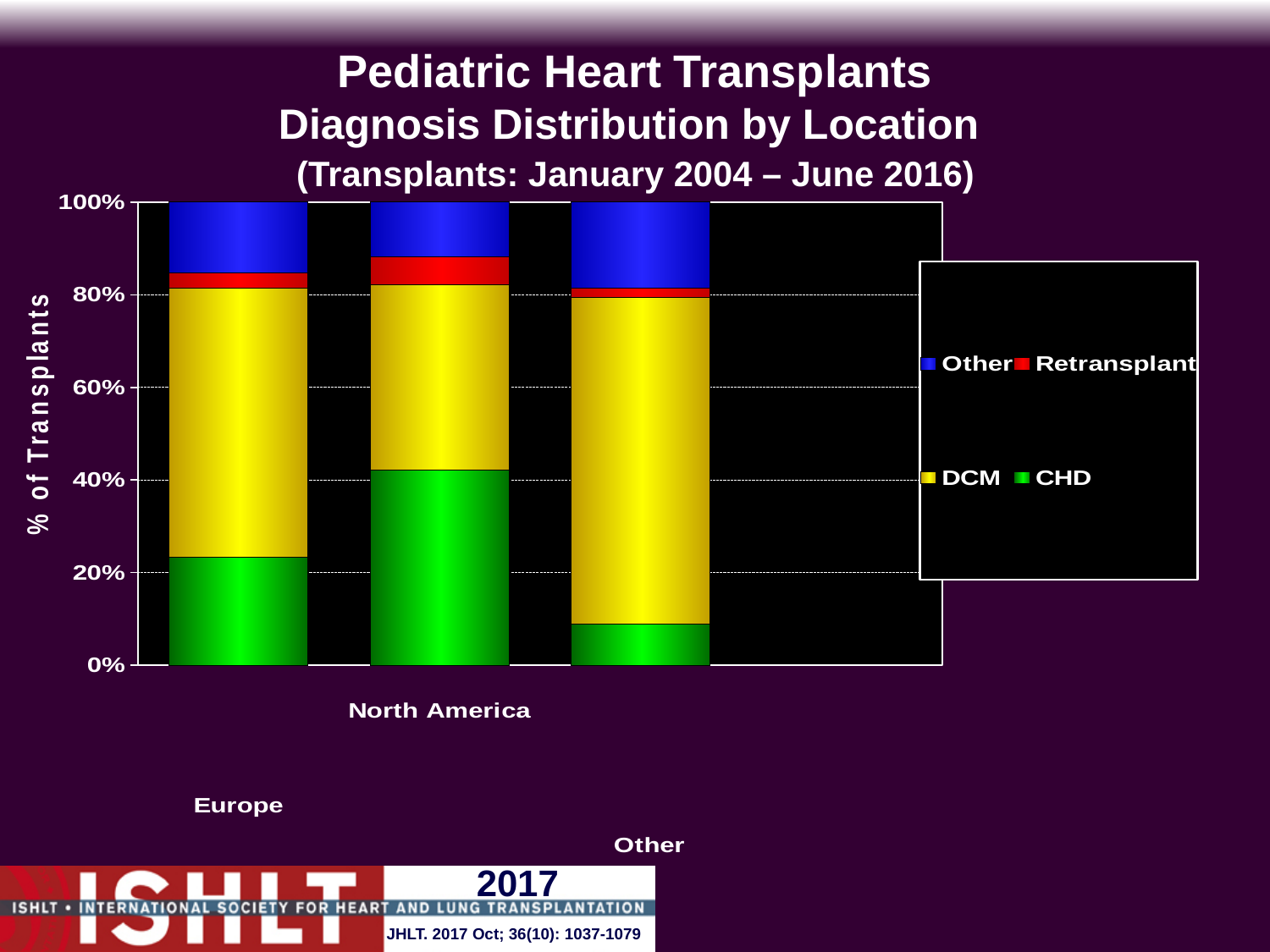
Which location has the smallest CHD share of transplants? Other What is the total height of the stacked bar for Europe? 100% Which location has the largest CHD share of transplants? North America How many series does the legend list? 4 What kind of chart is shown on the slide? Stacked bar chart Which colour represents DCM in the legend? Yellow Is the CHD share for the Other location greater or less than 20%? less Which is larger, the CHD share for Europe or for North America? North America How many location categories are plotted on the x axis? 3 Is the CHD share for Europe greater or less than 20%? greater What transplant period is given in the chart title? January 2004 – June 2016 Is the CHD share for North America greater or less than 40%? greater